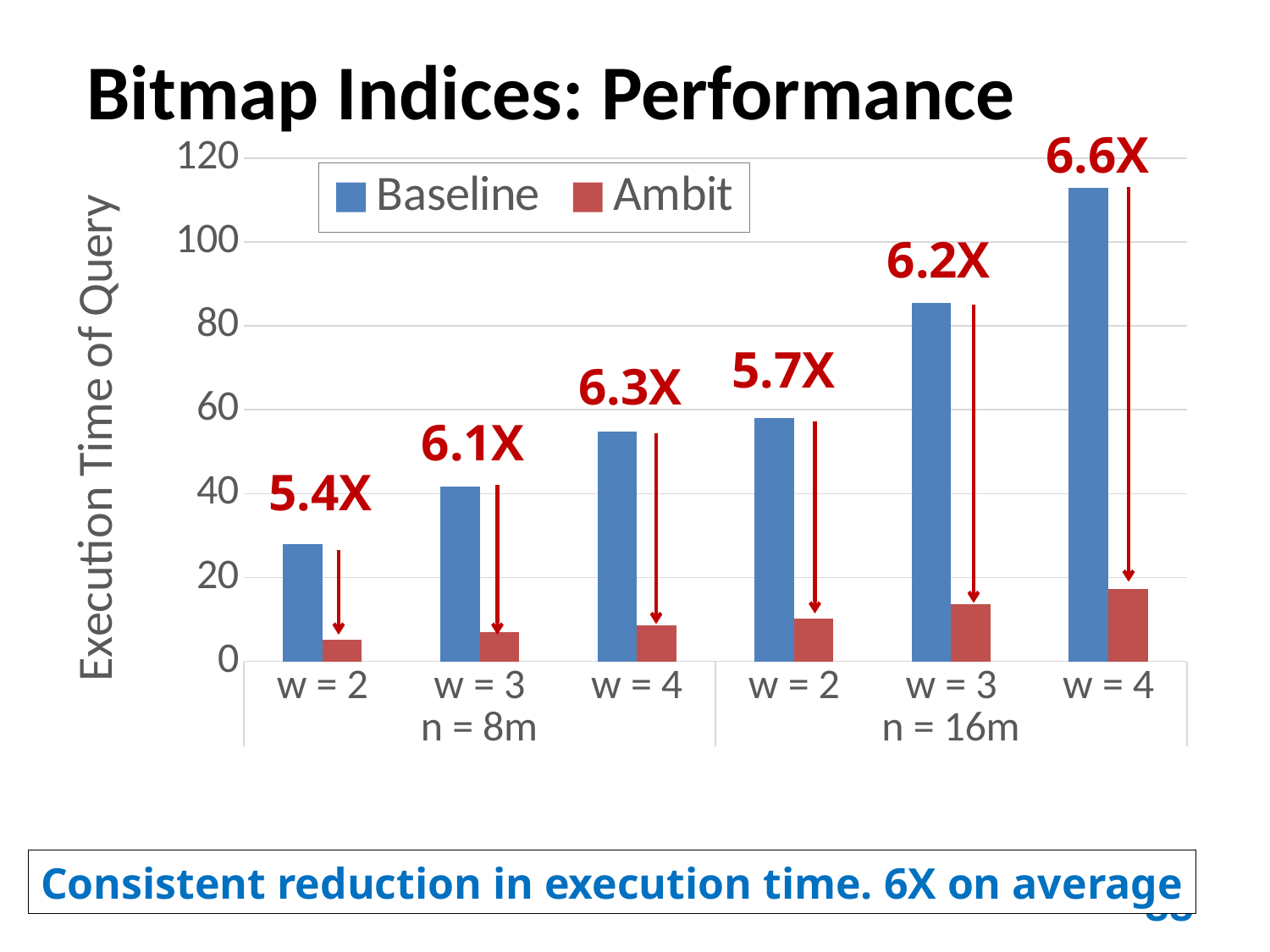
Is the Baseline value for w = 2 at n = 8m greater or less than 40? less Which category has the highest Baseline bar? w = 4, n = 16m How many categories (w values) are plotted along the x axis in total? 6 What kind of chart is shown on the slide? bar chart What speedup factor is printed above the bars for w = 4 at n = 16m? 6.6X Which category has the lowest Baseline bar? w = 2, n = 8m Is the Ambit value for w = 4 at n = 16m greater or less than 20? less For w = 3 at n = 8m, which is larger, the Baseline or the Ambit bar? Baseline What speedup factor is printed above the bars for w = 2 at n = 8m? 5.4X How many series does the legend list? 2 What is the label on the y axis of the chart? Execution Time of Query Is the Baseline value for w = 4 at n = 16m greater or less than 100? greater